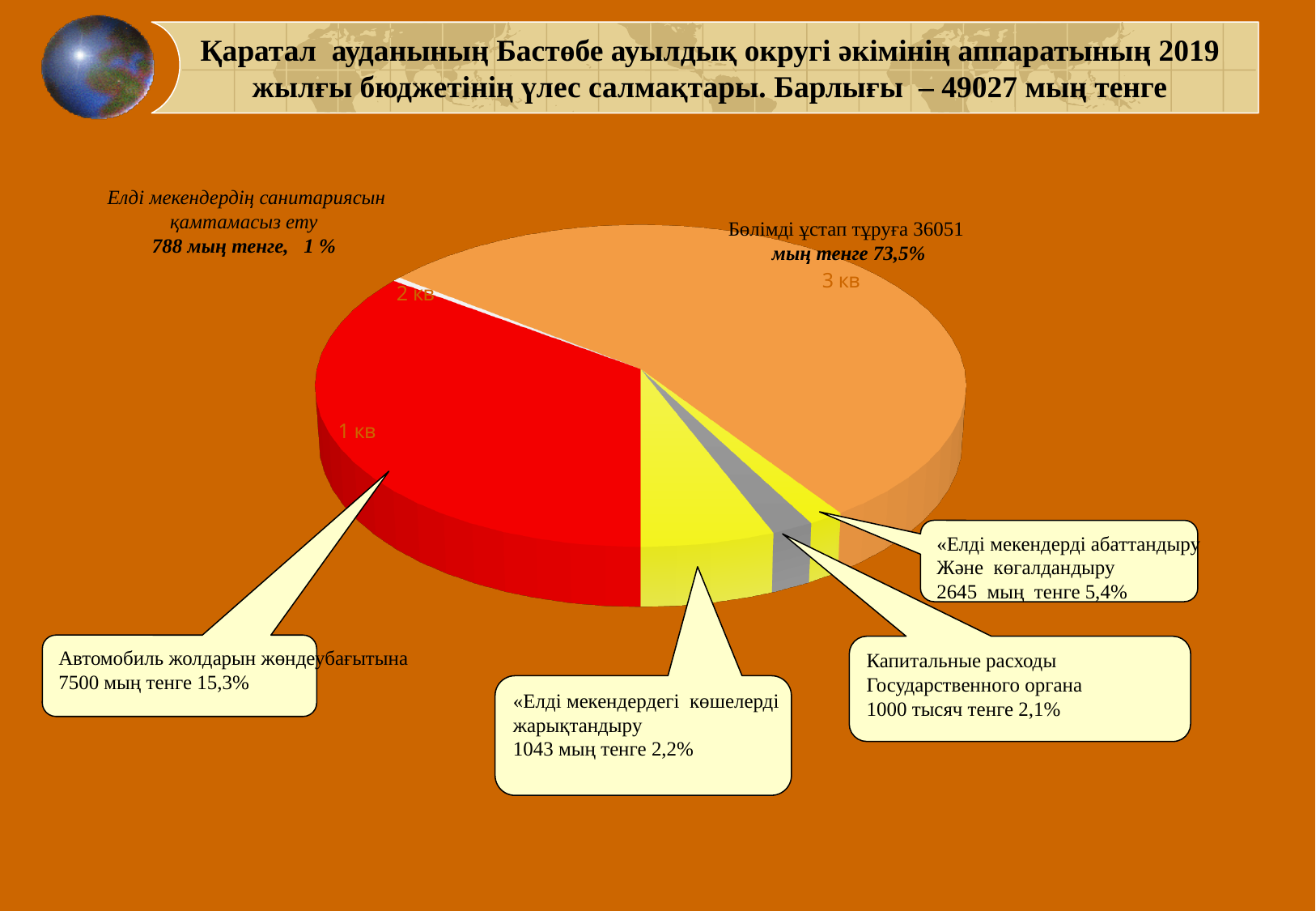
What is the difference in мың тенге between Автомобиль жолдарын жөндеу бағытына (7500) and Елді мекендерді абаттандыру және көгалдандыру (2645)? 4855 мың тенге What amount is shown for Бөлімді ұстап тұруға? 36051 мың тенге Which category has the largest share of the budget? Бөлімді ұстап тұруға How many slices does the pie chart have? 6 What amount is shown for Автомобиль жолдарын жөндеу бағытына? 7500 мың тенге What amount is shown for Елді мекендердегі көшелерді жарықтандыру? 1043 мың тенге What share of the budget does Бөлімді ұстап тұруға take? 73,5% Which is larger: Автомобиль жолдарын жөндеу бағытына or Елді мекендерді абаттандыру және көгалдандыру? Автомобиль жолдарын жөндеу бағытына What percentage is shown for Елді мекендерді абаттандыру және көгалдандыру? 5,4% What kind of chart is shown on the slide? pie chart What is the total budget stated in the slide title? 49027 мың тенге Which category has the smallest share of the budget? Елді мекендердің санитариясын қамтамасыз ету